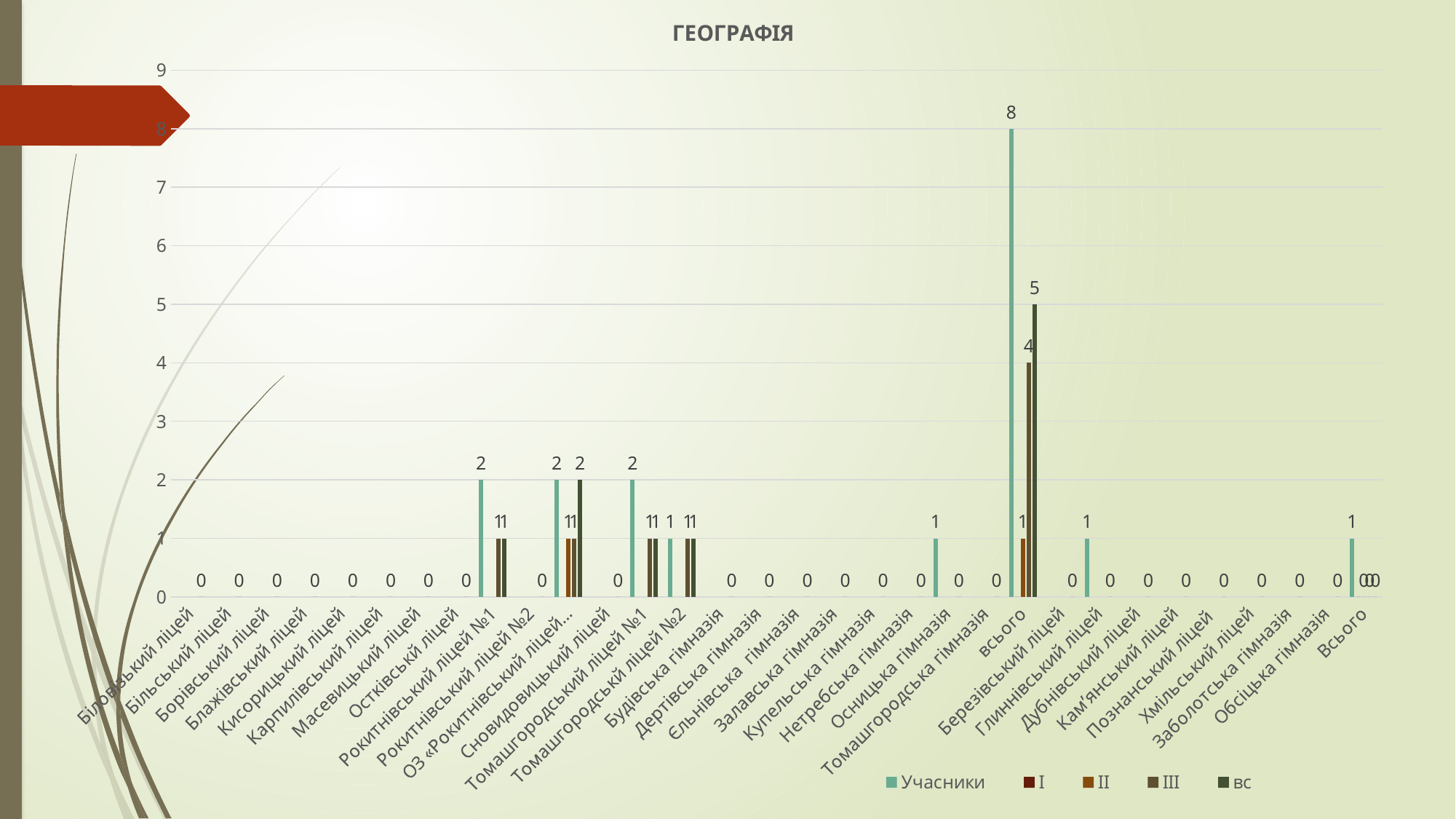
What is the difference between the Учасники value and the вс value for всього? 3 Which category has the highest Учасники value? всього How many series does the legend list? 5 Which has the larger Учасники value: Рокитнівський ліцей №1 or Томашгородський ліцей №2? Рокитнівський ліцей №1 What is the Учасники value for всього? 8 What is the title of the chart? ГЕОГРАФІЯ What is the Учасники value for Осницька гімназія? 1 What is the III value for всього? 4 What is the вс value for всього? 5 What is the Учасники value for Рокитнівський ліцей №1? 2 What kind of chart is shown on the slide? bar chart What is the Учасники value for Глиннівський ліцей? 1